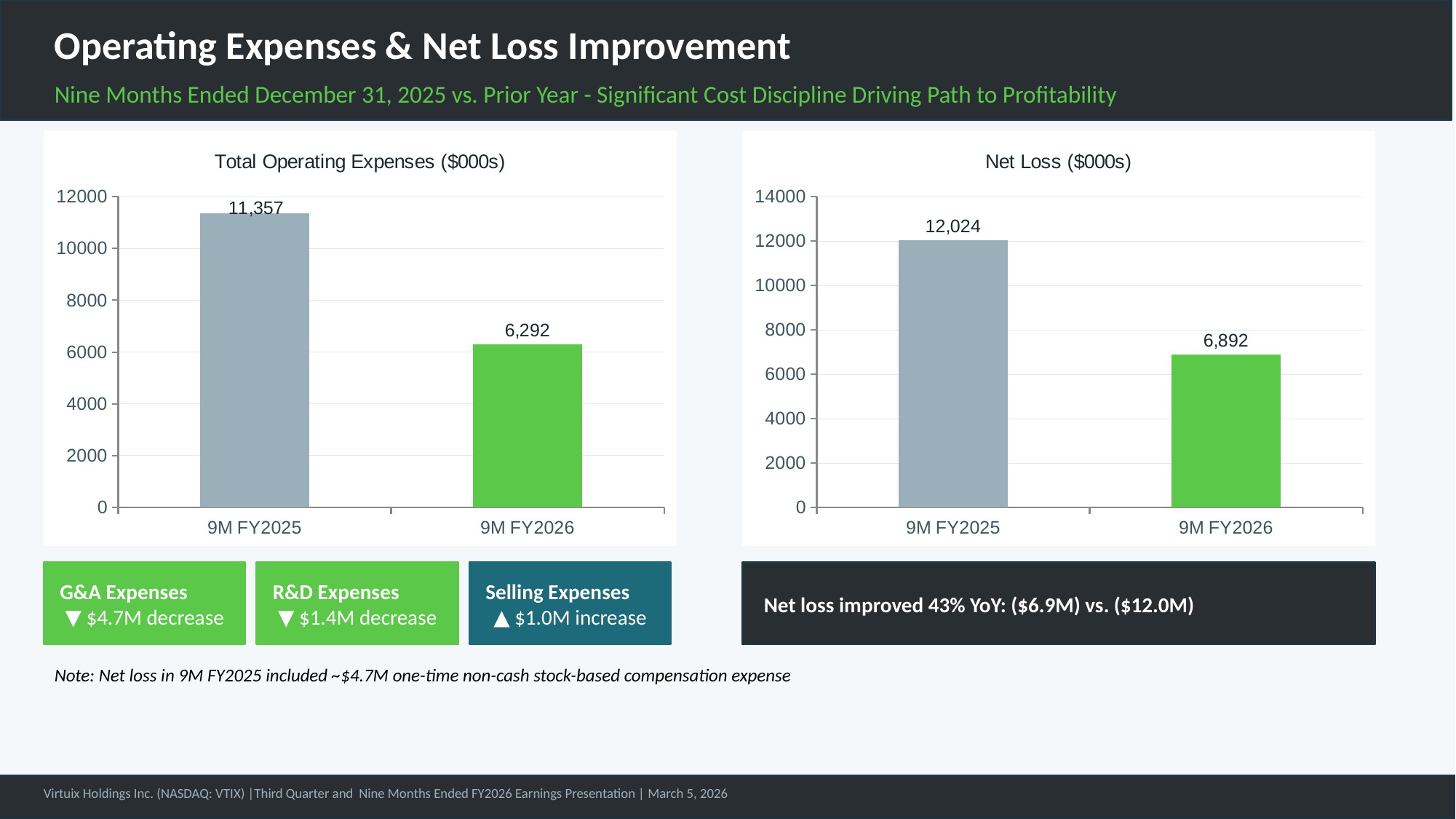
In the Net Loss ($000s) chart, what is the value for 9M FY2026? 6,892 How many categories are shown on the x axis of the Net Loss ($000s) chart? 2 In the Total Operating Expenses ($000s) chart, what is the value for 9M FY2026? 6,292 In the Total Operating Expenses ($000s) chart, do the values rise or fall from 9M FY2025 to 9M FY2026? fall In the Total Operating Expenses ($000s) chart, which period has the lowest value? 9M FY2026 What kind of chart is the Net Loss ($000s) chart? bar chart In the Net Loss ($000s) chart, what colour is the 9M FY2026 bar? green In the Net Loss ($000s) chart, what is the difference between the 9M FY2025 and 9M FY2026 values? 5,132 In the Net Loss ($000s) chart, what is the value for 9M FY2025? 12,024 In the Total Operating Expenses ($000s) chart, what is the difference between the 9M FY2025 and 9M FY2026 values? 5,065 In the Net Loss ($000s) chart, which period has the higher value? 9M FY2025 In the Total Operating Expenses ($000s) chart, what is the value for 9M FY2025? 11,357